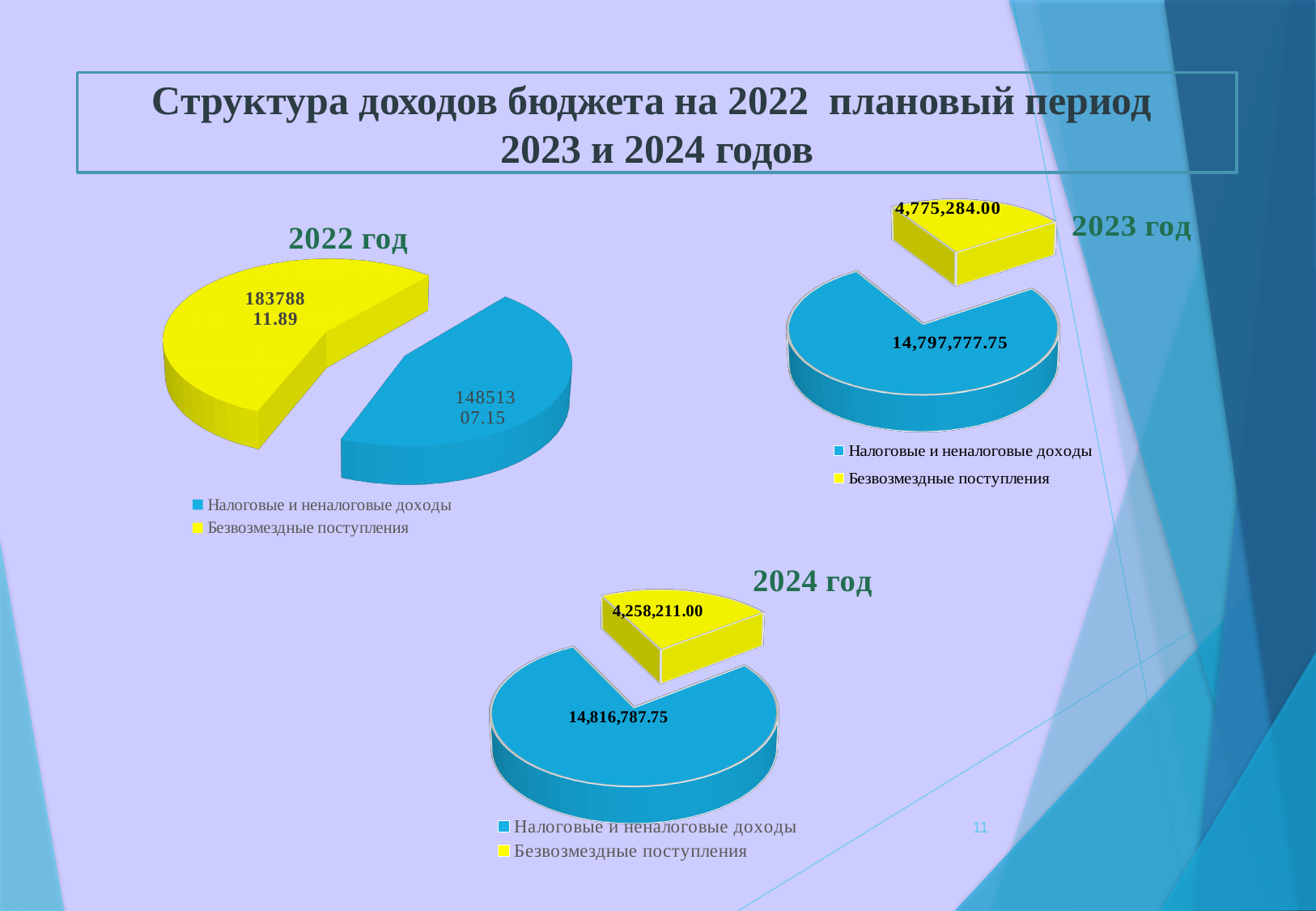
In the 2023 год chart, what is the difference between Налоговые и неналоговые доходы and Безвозмездные поступления? 10,022,493.75 In the 2024 год chart, what is the value for Безвозмездные поступления? 4,258,211.00 Which colour represents Безвозмездные поступления in the charts? yellow Is Безвозмездные поступления larger in the 2023 год chart or in the 2024 год chart? 2023 год In the 2024 год chart, what is the difference between Налоговые и неналоговые доходы and Безвозмездные поступления? 10,558,576.75 What type of chart is used for the 2022 год chart? pie chart In the 2022 год chart, which category is the smallest? Налоговые и неналоговые доходы In the 2024 год chart, what is the value for Налоговые и неналоговые доходы? 14,816,787.75 In the 2024 год chart, which category is the largest? Налоговые и неналоговые доходы How many slices does the 2023 год chart have? 2 In the 2023 год chart, what is the value for Безвозмездные поступления? 4,775,284.00 In the 2023 год chart, what is the value for Налоговые и неналоговые доходы? 14,797,777.75